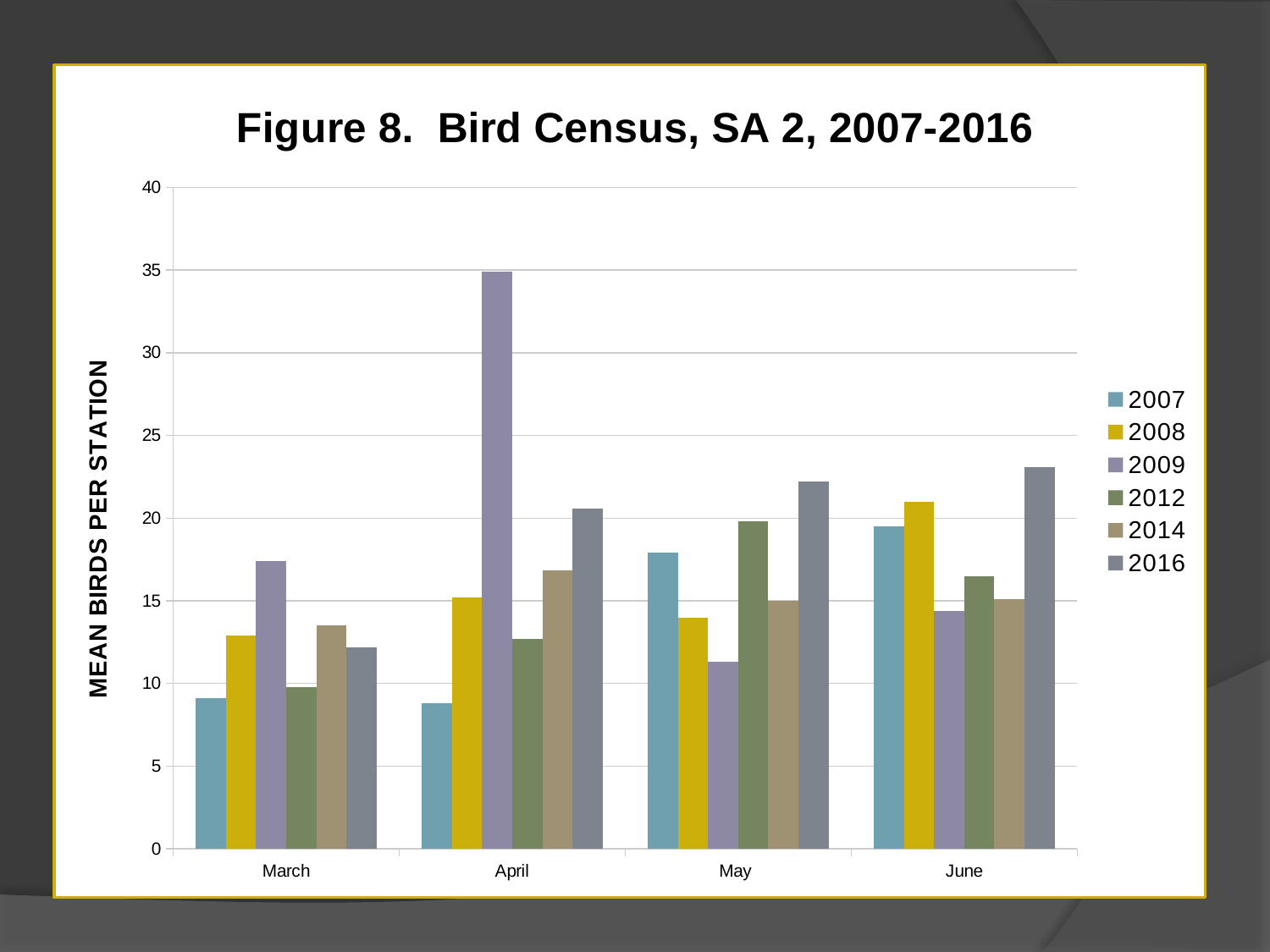
Is the value for 2007 in March greater or less than 10? less In which month is the 2009 bar the tallest? April What is the title of the y axis? MEAN BIRDS PER STATION How many months are shown on the x axis? 4 In March, which is larger: the value for 2009 or the value for 2014? 2009 Is the value for 2016 in June greater or less than 20? greater Which year has the lowest value in April? 2007 What kind of chart is shown on the slide? bar chart Do the values for 2016 rise or fall from March to June? rise How many series does the legend list? 6 Is the value for 2009 in April greater or less than 30? greater In May, which is larger: the value for 2016 or the value for 2007? 2016